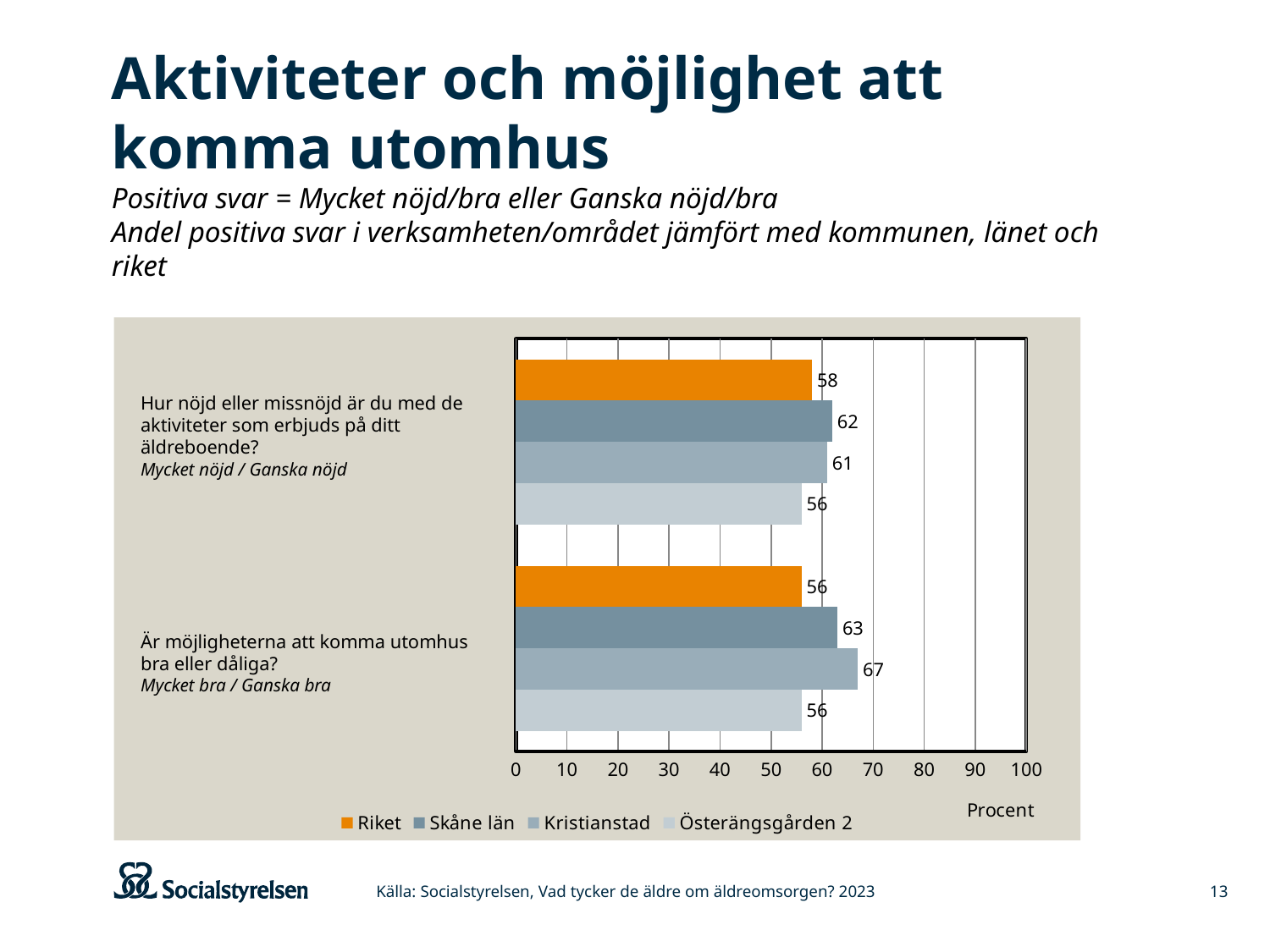
What is the label of the x axis? Procent How many series does the legend list? 4 What is the value for Skåne län for the question about opportunities to get outdoors? 63 How many question categories are shown on the chart? 2 What is the value for Kristianstad for the question about opportunities to get outdoors (Är möjligheterna att komma utomhus bra eller dåliga?)? 67 What is the difference between Kristianstad and Österängsgården 2 for the question about opportunities to get outdoors? 11 What is the value for Riket for the question about activities offered at the care home (Hur nöjd eller missnöjd är du med de aktiviteter som erbjuds på ditt äldreboende?)? 58 What kind of chart is shown on the slide? bar chart What is the value for Österängsgården 2 for the question about activities offered at the care home? 56 Which series has the highest value for the question about opportunities to get outdoors? Kristianstad Which series has the lowest value for the question about activities offered at the care home? Österängsgården 2 Which is larger for the question about activities offered at the care home: Skåne län or Kristianstad? Skåne län